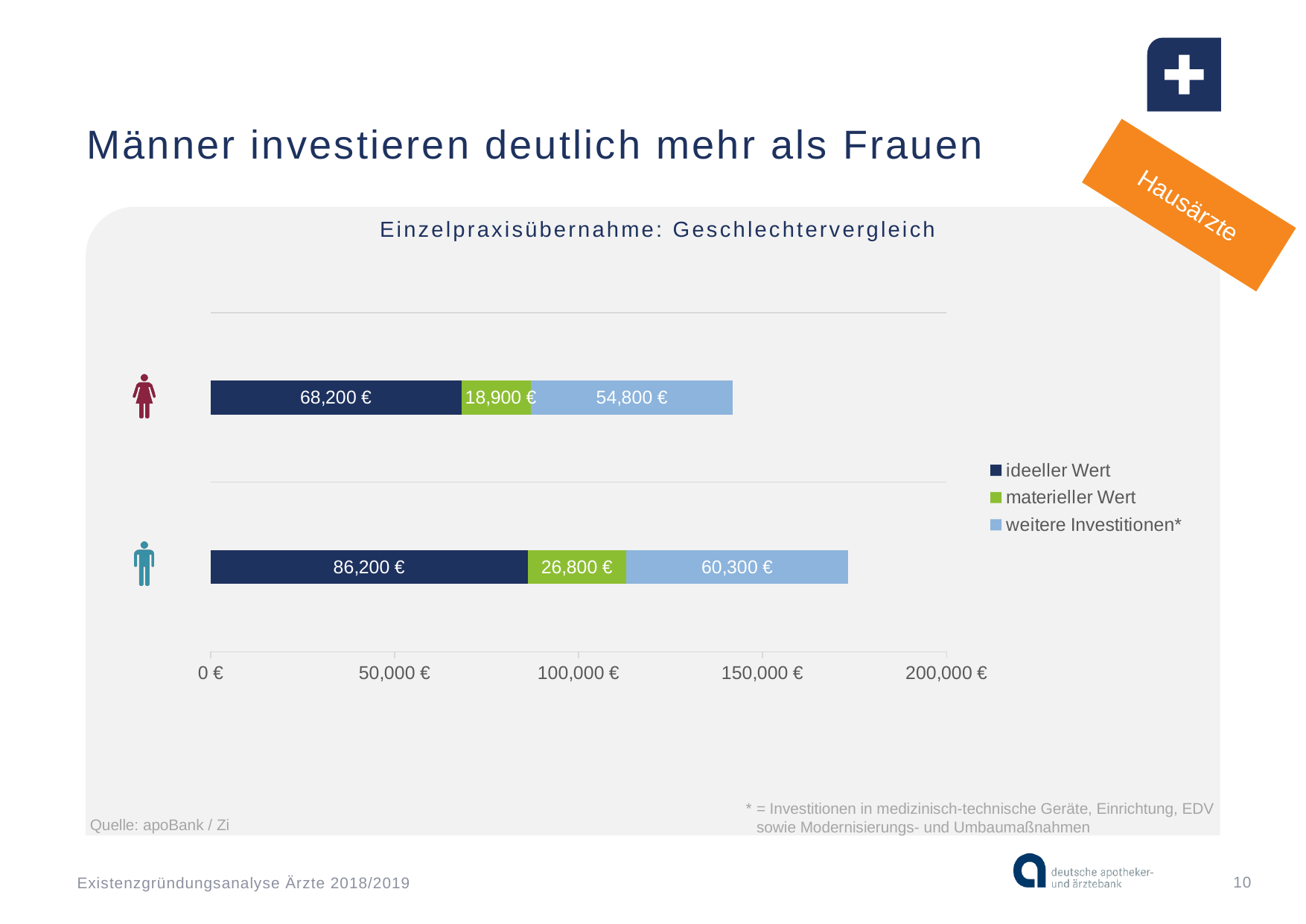
What is the total of the stacked bar for women? 141,900 € What is the weitere Investitionen* value for men? 60,300 € What is the weitere Investitionen* value for women? 54,800 € Which group has the larger materieller Wert, men or women? men How many series does the legend list? 3 What is the title of the chart? Einzelpraxisübernahme: Geschlechtervergleich What is the difference between the ideeller Wert for men and for women? 18,000 € What is the total of the stacked bar for men? 173,300 € Is the total bar for women greater or less than 150,000 €? less What is the ideeller Wert value for the bar with the female icon (women)? 68,200 € What kind of chart is shown on the slide? stacked bar chart What is the materieller Wert value for the bar with the male icon (men)? 26,800 €